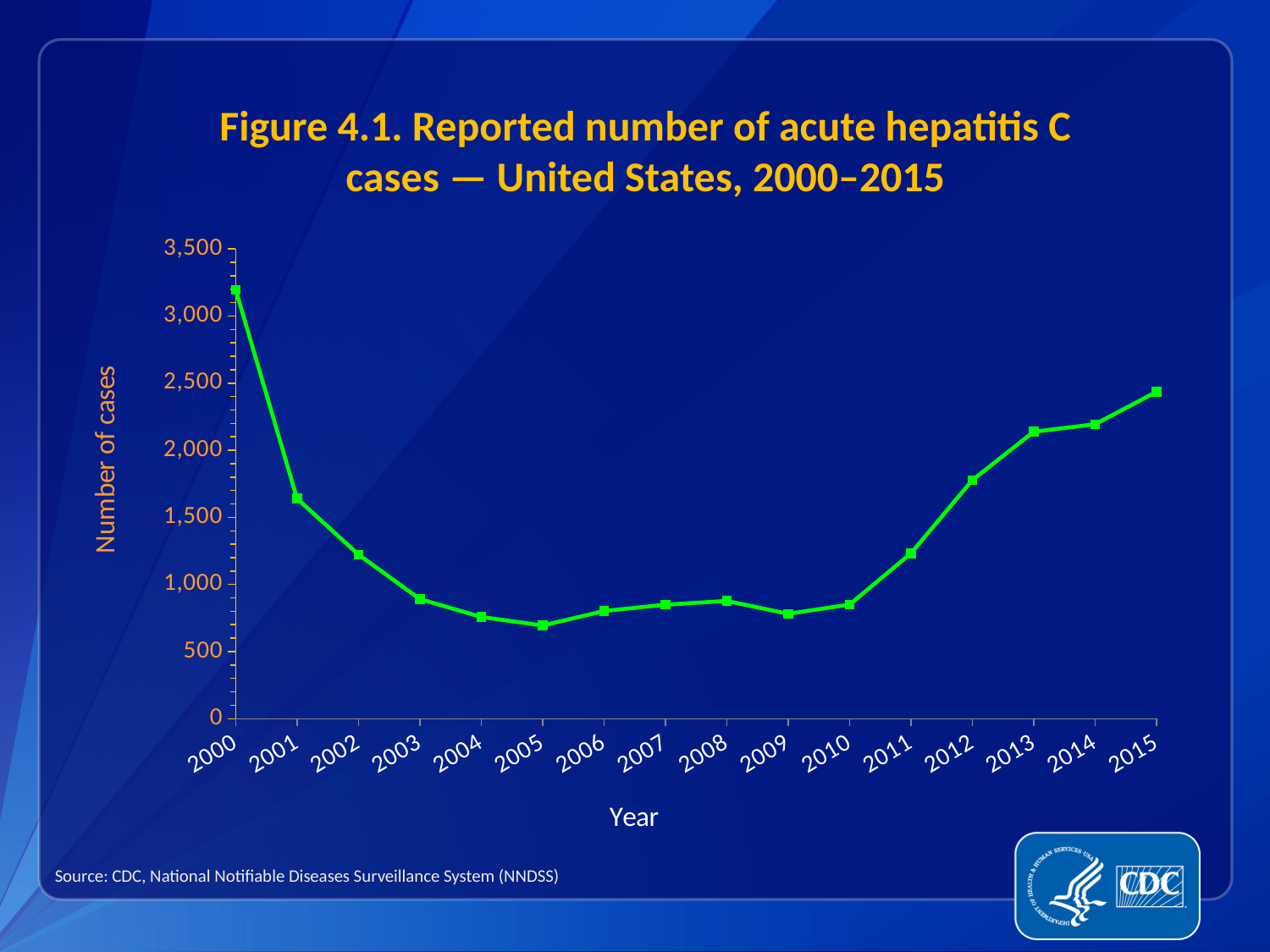
Did the number of cases rise or fall from 2010 to 2015? rise In which year was the reported number of acute hepatitis C cases lowest? 2005 What is the label of the y axis? Number of cases Is the number of cases in 2005 greater or less than 1,000? less In which year was the reported number of acute hepatitis C cases highest? 2000 How many years are plotted on the x axis? 16 What type of chart is shown on the slide? line chart Which year had more reported cases, 2011 or 2012? 2012 Is the number of cases in 2015 greater or less than 2,500? less Which year had more reported cases, 2000 or 2015? 2000 Is the number of cases in 2013 greater or less than 2,000? greater